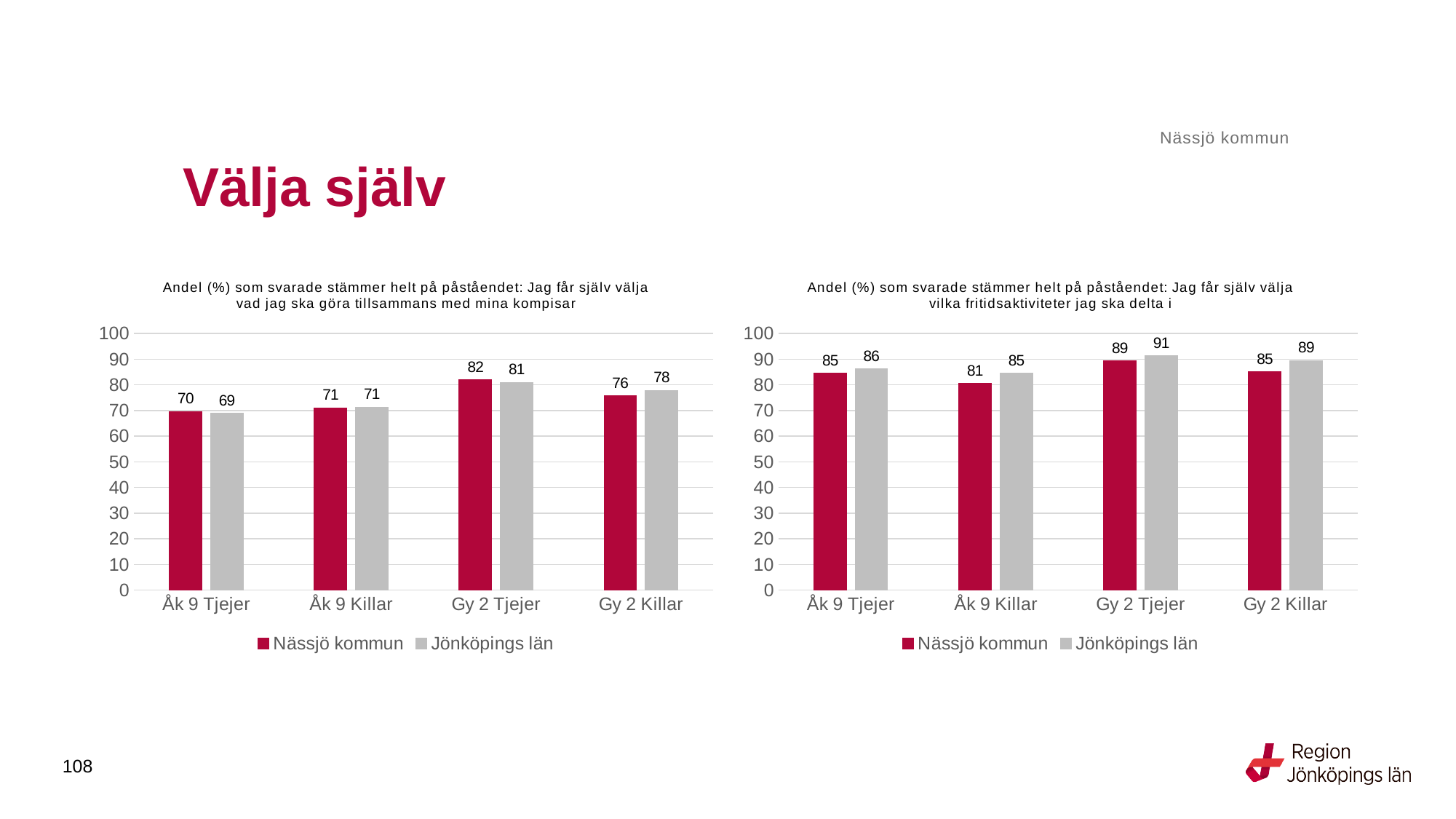
In the right chart (about choosing leisure activities), what is the value for Jönköpings län for Gy 2 Tjejer? 91 In the right chart (about choosing leisure activities), which category has the lowest value for Nässjö kommun? Åk 9 Killar What kind of chart is the left chart? Bar chart In the left chart (about choosing what to do with friends), which category has the highest value for Nässjö kommun? Gy 2 Tjejer How many series does the legend of the right chart list? 2 In the left chart (about choosing what to do with friends), what is the difference between Jönköpings län and Nässjö kommun for Gy 2 Killar? 2 In the right chart (about choosing leisure activities), what is the value for Nässjö kommun for Åk 9 Killar? 81 In the right chart (about choosing leisure activities), what is the difference between Jönköpings län and Nässjö kommun for Åk 9 Killar? 4 How many categories are shown on the x axis of the left chart? 4 In the left chart (about choosing what to do with friends), what is the value for Jönköpings län for Gy 2 Killar? 78 In the right chart (about choosing leisure activities), which is larger for Gy 2 Killar: Nässjö kommun or Jönköpings län? Jönköpings län In the left chart (about choosing what to do with friends), what is the value for Nässjö kommun for Gy 2 Tjejer? 82